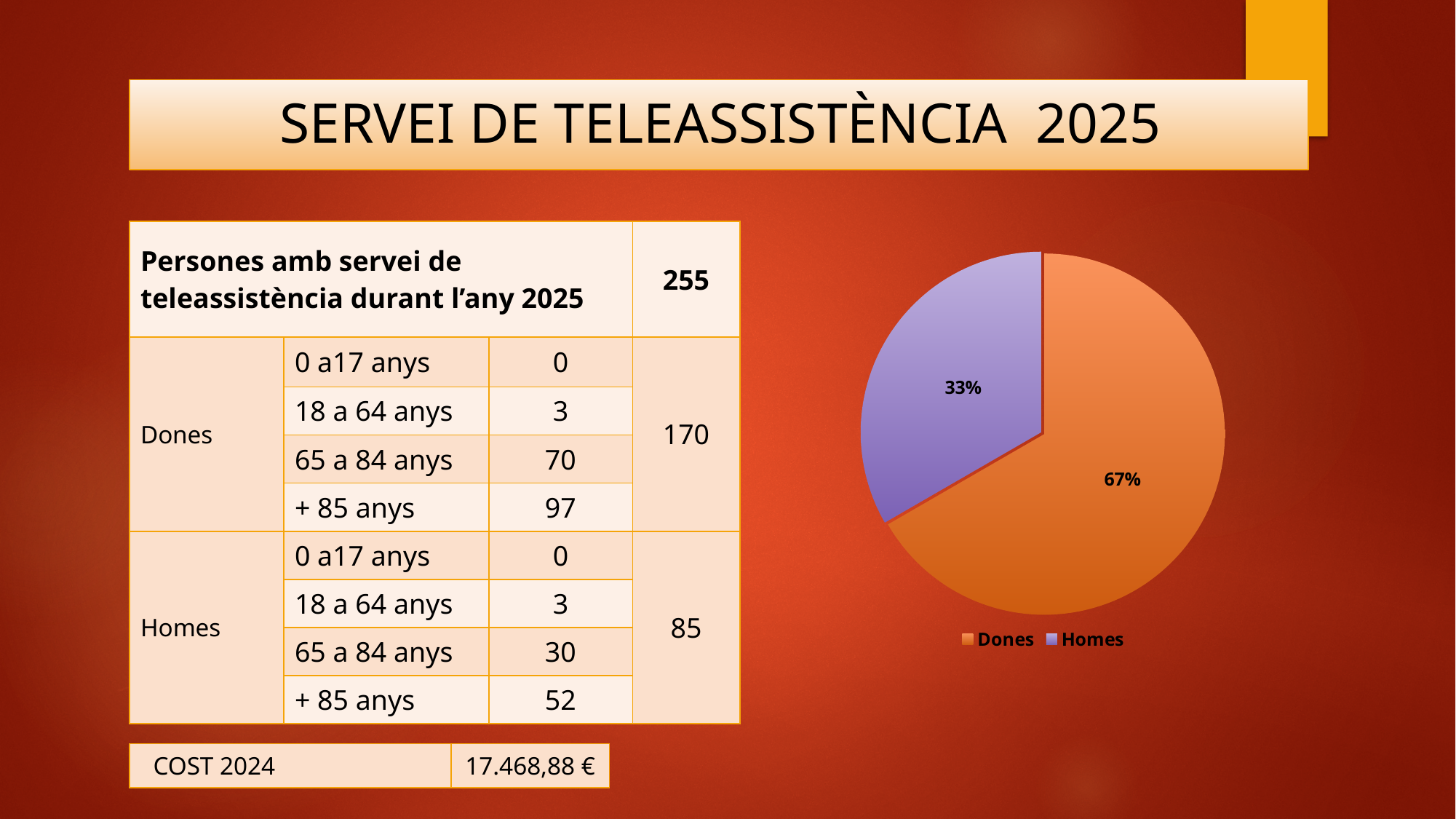
What share of the pie chart does the Dones slice represent? 67% What share of the pie chart does the Homes slice represent? 33% How many entries does the pie chart's legend list? 2 What colour is the Dones slice in the pie chart? Orange Which slice is larger in the pie chart, Dones or Homes? Dones What are the two entries listed in the pie chart's legend? Dones and Homes What is the difference in percentage points between the Dones and Homes slices? 34 How many slices does the pie chart have? 2 Is the share for Dones greater or less than 50%? greater Which category has the largest slice in the pie chart? Dones Which category has the smallest slice in the pie chart? Homes What kind of chart is shown on the slide? Pie chart